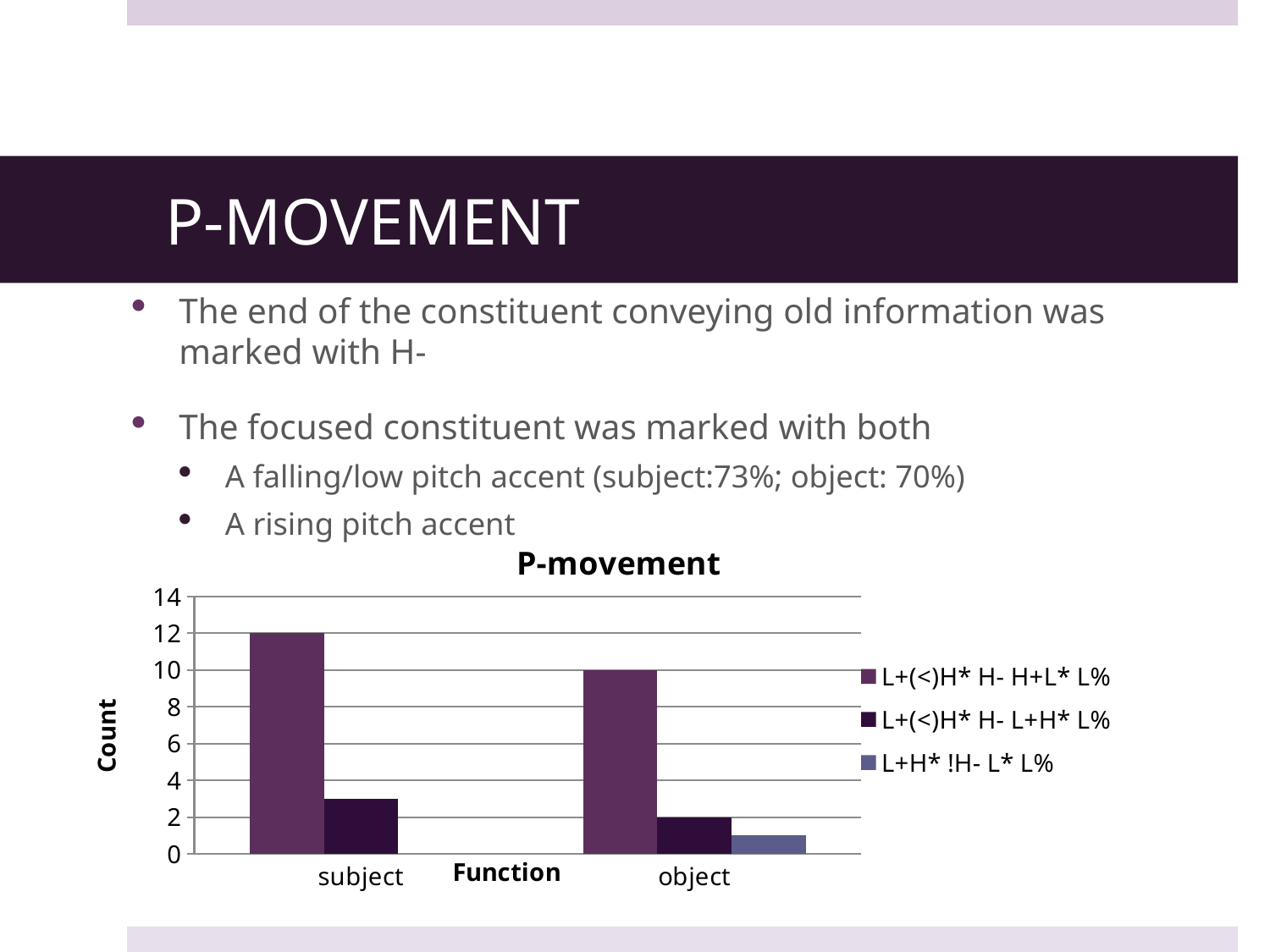
How many series does the chart legend list? 3 Is the count for L+H* !H- L* L% in the object category greater or less than 2? less Is the count for L+(<)H* H- L+H* L% in the subject category greater or less than 4? less What is the count for L+(<)H* H- H+L* L% in the subject category? 12 How many categories are shown on the x axis of the chart? 2 What type of chart is shown on the slide? bar chart What is the difference between the L+(<)H* H- H+L* L% counts for subject and object? 2 What is the title of the chart? P-movement Which category has the higher count for L+(<)H* H- H+L* L%, subject or object? subject Which series has the highest count in the subject category? L+(<)H* H- H+L* L% What is the count for L+(<)H* H- L+H* L% in the object category? 2 What is the count for L+(<)H* H- H+L* L% in the object category? 10